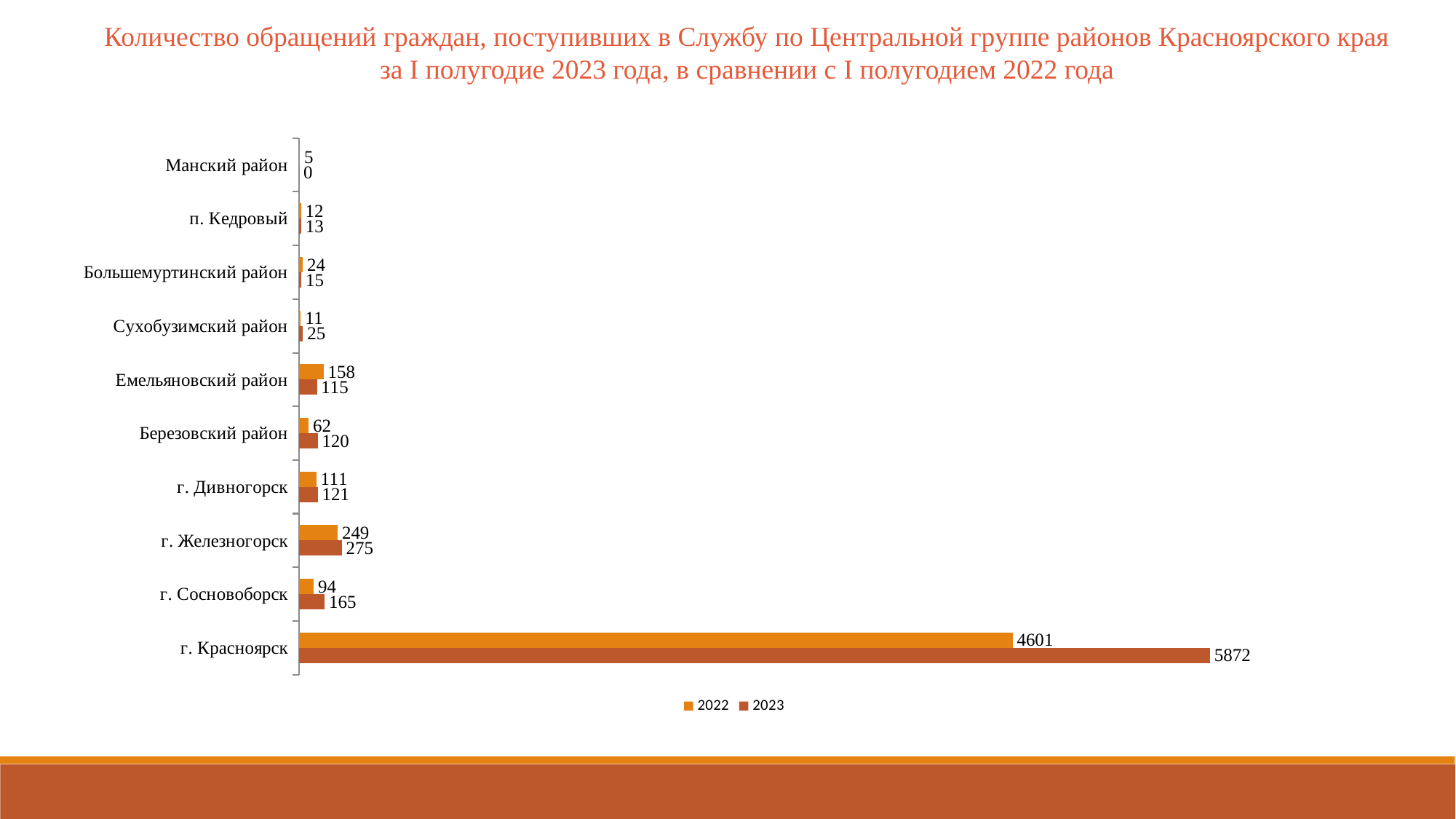
What is the difference between the 2022 and 2023 values for Емельяновский район? 43 What kind of chart is shown on the slide? bar chart What is the value for г. Железногорск in the 2022 series? 249 How many series does the legend list? 2 How many categories are shown on the chart? 10 What is the value for Манский район in the 2023 series? 0 Which category has the highest value in the 2022 series? г. Красноярск Which is larger for Большемуртинский район: the 2022 value or the 2023 value? 2022 What is the value for г. Красноярск in the 2023 series? 5872 Which category has the lowest value in the 2023 series? Манский район What is the difference between the 2023 and 2022 values for г. Красноярск? 1271 Which is larger for г. Сосновоборск: the 2022 value or the 2023 value? 2023